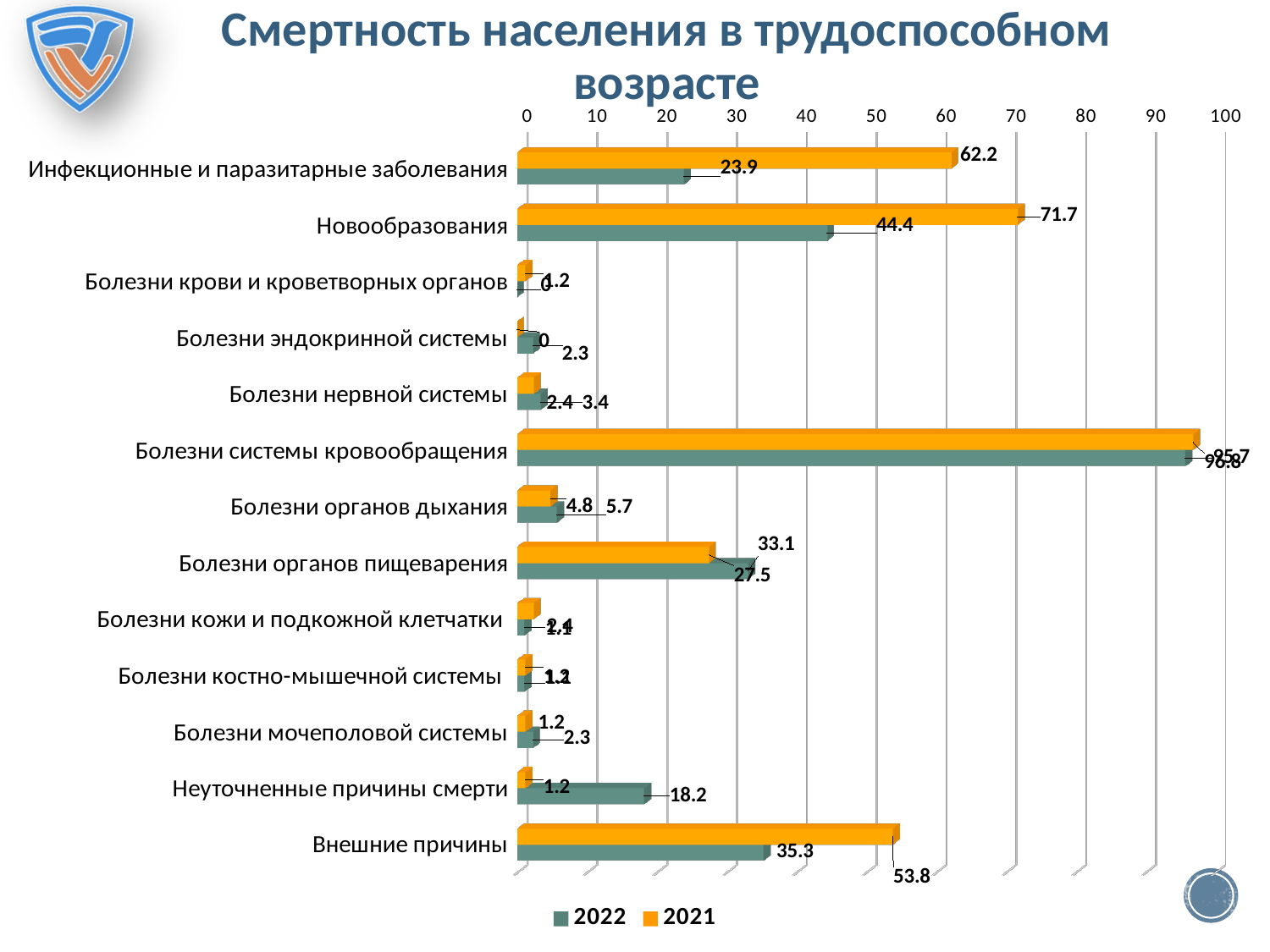
What is the 2022 value for Неуточненные причины смерти? 18.2 What is the 2021 value for Внешние причины? 53.8 How many series does the legend list? 2 How many categories (causes of death) are shown on the chart? 13 Which category has the highest value for 2021? Болезни системы кровообращения For Инфекционные и паразитарные заболевания, which year has the larger value, 2021 or 2022? 2021 What is the 2022 value for Новообразования? 44.4 What is the difference between the 2021 and 2022 values for Новообразования? 27.3 Is the 2022 value for Болезни системы кровообращения greater or less than 90? greater What is the difference between the 2021 and 2022 values for Внешние причины? 18.5 What kind of chart is shown on the slide? bar chart What is the 2021 value for Инфекционные и паразитарные заболевания? 62.2